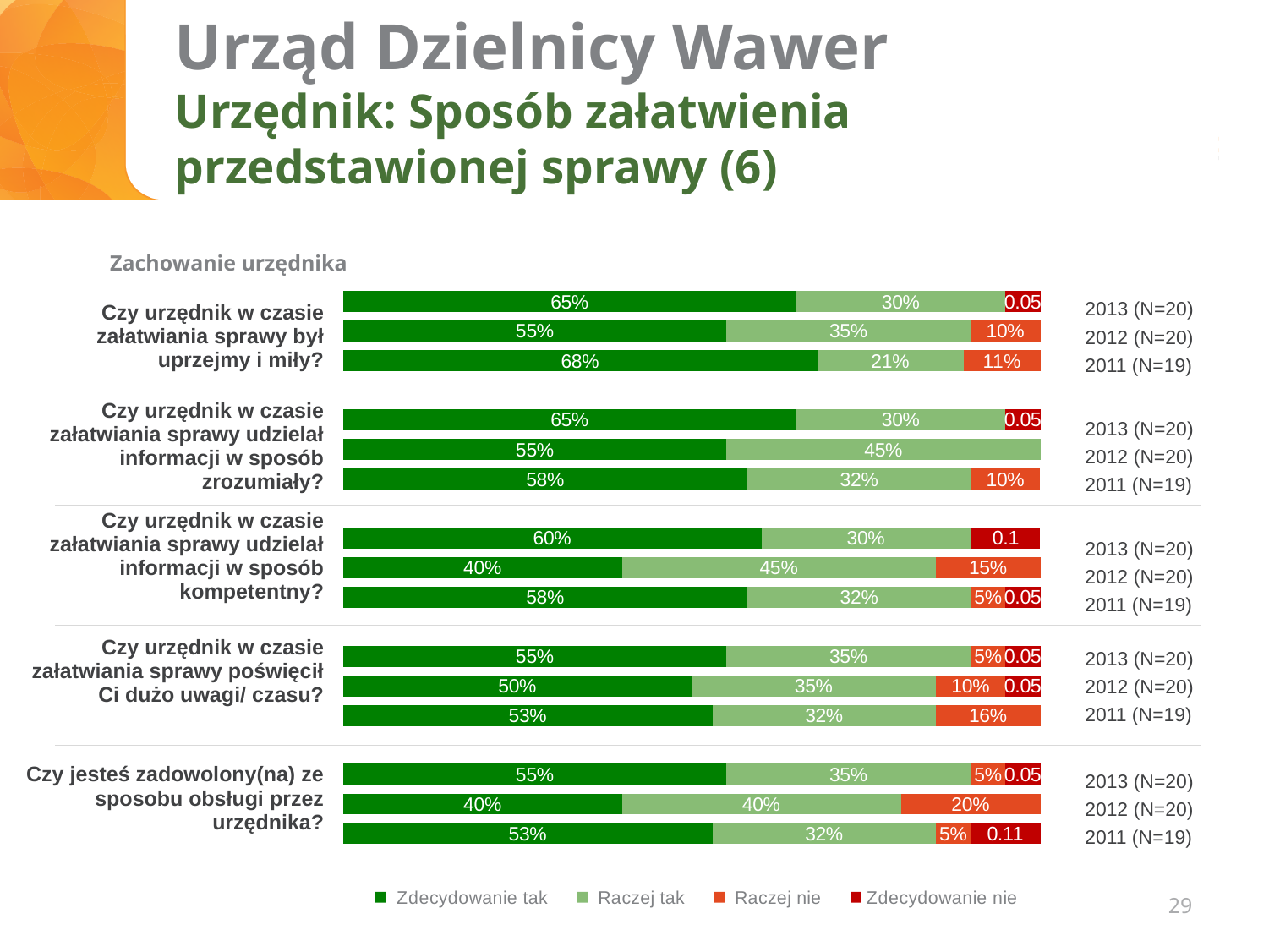
For the question "Czy urzędnik w czasie załatwiania sprawy był uprzejmy i miły?", how much higher is the "Zdecydowanie tak" share in 2011 than in 2012? 13 percentage points For the question "Czy jesteś zadowolony(na) ze sposobu obsługi przez urzędnika?", what percentage answered "Raczej nie" in 2012? 20% What kind of chart is used on this slide? Stacked bar chart For the question "Czy urzędnik w czasie załatwiania sprawy poświęcił Ci dużo uwagi/ czasu?", what percentage answered "Raczej nie" in 2011? 16% For the question "Czy urzędnik w czasie załatwiania sprawy udzielał informacji w sposób kompetentny?", what percentage answered "Zdecydowanie tak" in 2012? 40% For the question "Czy urzędnik w czasie załatwiania sprawy udzielał informacji w sposób zrozumiały?", what percentage answered "Raczej tak" in 2012? 45% For the question "Czy urzędnik w czasie załatwiania sprawy był uprzejmy i miły?", which year had the highest "Zdecydowanie tak" share? 2011 For the question "Czy urzędnik w czasie załatwiania sprawy był uprzejmy i miły?", what percentage answered "Raczej tak" in 2011? 21% For the question "Czy urzędnik w czasie załatwiania sprawy udzielał informacji w sposób kompetentny?", which year had the larger "Zdecydowanie tak" share, 2013 or 2012? 2013 For the question "Czy urzędnik w czasie załatwiania sprawy był uprzejmy i miły?", what percentage answered "Zdecydowanie tak" in 2013? 65% How many respondents (N) are indicated for the 2011 bars? 19 How many answer categories does the legend list? 4